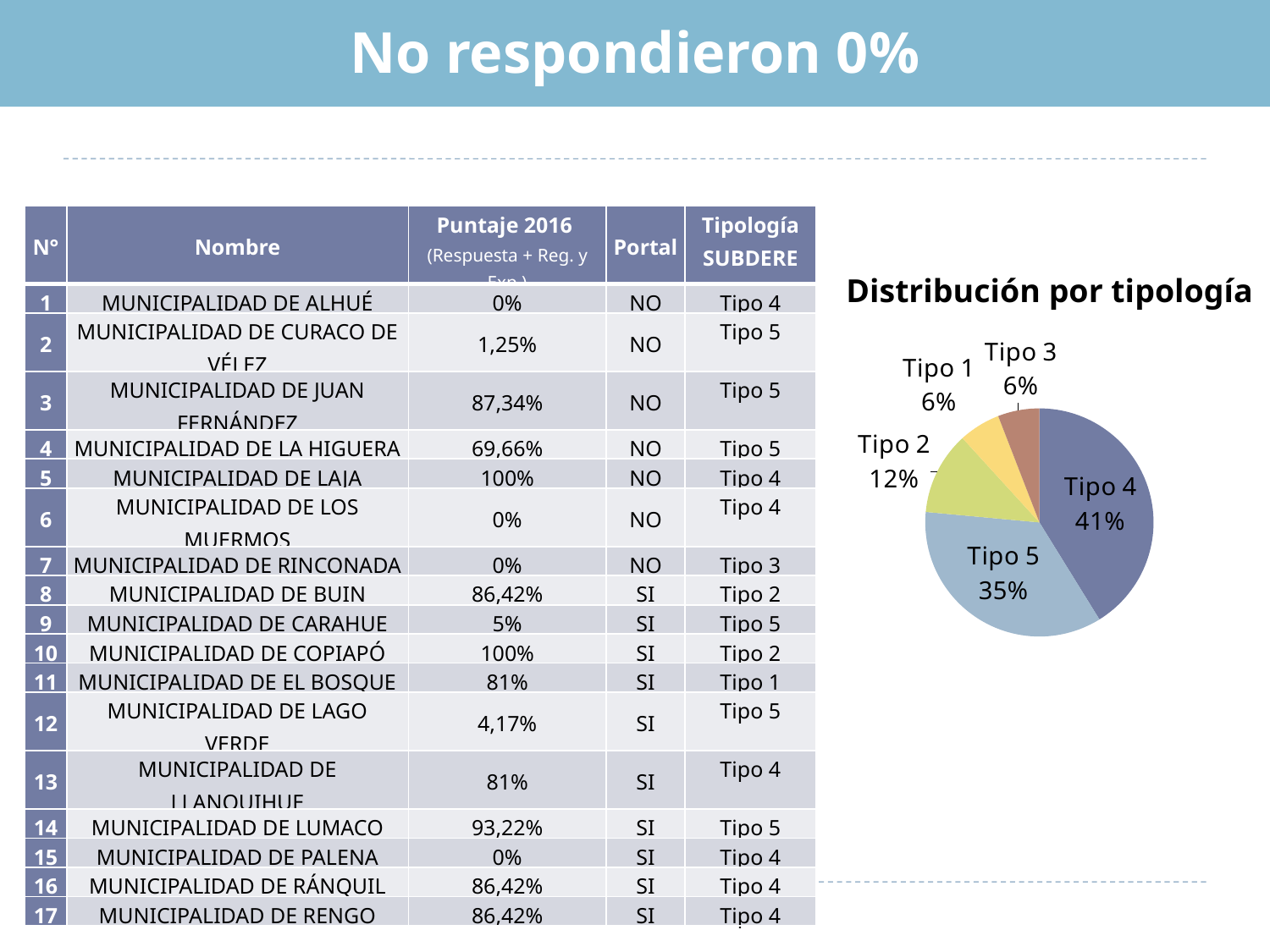
In the 'Distribución por tipología' chart, what share does Tipo 1 have? 6% In the 'Distribución por tipología' chart, what share does Tipo 2 have? 12% In the 'Distribución por tipología' chart, what is the difference between the shares of Tipo 4 and Tipo 5? 6% What is the title of the pie chart on the slide? Distribución por tipología In the 'Distribución por tipología' chart, what is the combined share of Tipo 4 and Tipo 5? 76% In the 'Distribución por tipología' chart, what share does Tipo 4 have? 41% In the 'Distribución por tipología' chart, which is larger, the share of Tipo 2 or the share of Tipo 1? Tipo 2 In the 'Distribución por tipología' chart, which tipología has the largest slice? Tipo 4 What kind of chart is 'Distribución por tipología'? pie chart How many slices does the 'Distribución por tipología' pie chart have? 5